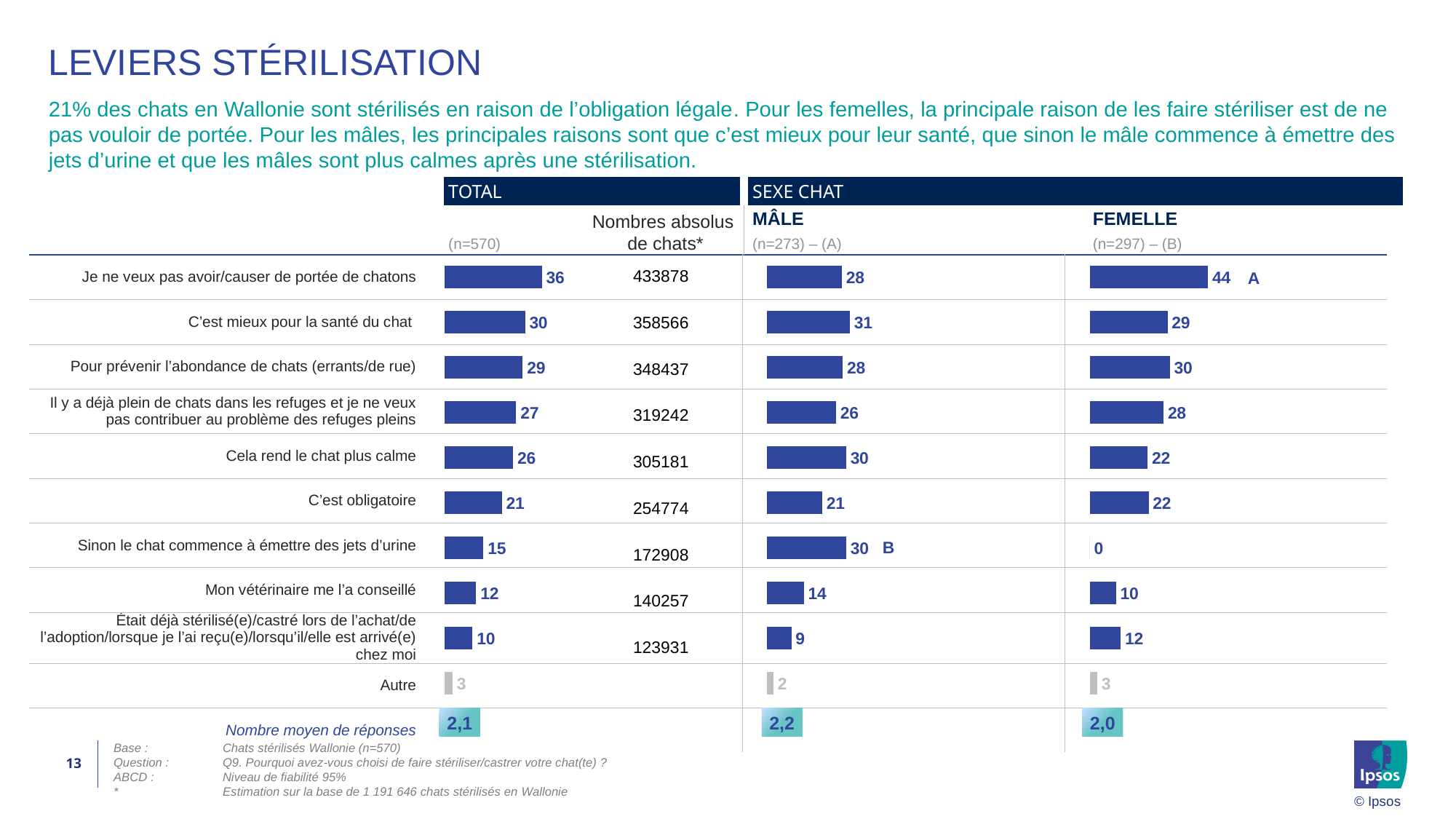
In the TOTAL chart, what is the value for "C'est obligatoire"? 21 For "Cela rend le chat plus calme", what is the difference between the MÂLE value and the FEMELLE value? 8 In the MÂLE chart, what is the value for "Sinon le chat commence à émettre des jets d'urine"? 30 What kind of chart is used in the TOTAL column? Bar chart In the TOTAL chart, which category has the highest value? Je ne veux pas avoir/causer de portée de chatons In the FEMELLE chart, which is larger: "Mon vétérinaire me l'a conseillé" or "Était déjà stérilisé(e)/castré lors de l'achat/de l'adoption/lorsque je l'ai reçu(e)/lorsqu'il/elle est arrivé(e) chez moi"? Était déjà stérilisé(e)/castré lors de l'achat/de l'adoption/lorsque je l'ai reçu(e)/lorsqu'il/elle est arrivé(e) chez moi In the MÂLE chart, what is the value for "Mon vétérinaire me l'a conseillé"? 14 How many categories are shown in the TOTAL chart? 10 In the FEMELLE chart, which category has the lowest value? Sinon le chat commence à émettre des jets d'urine In the TOTAL chart, what is the difference between "Je ne veux pas avoir/causer de portée de chatons" and "C'est mieux pour la santé du chat"? 6 In the FEMELLE chart, what is the value for "Je ne veux pas avoir/causer de portée de chatons"? 44 What is the "Nombre moyen de réponses" shown under the MÂLE chart? 2,2